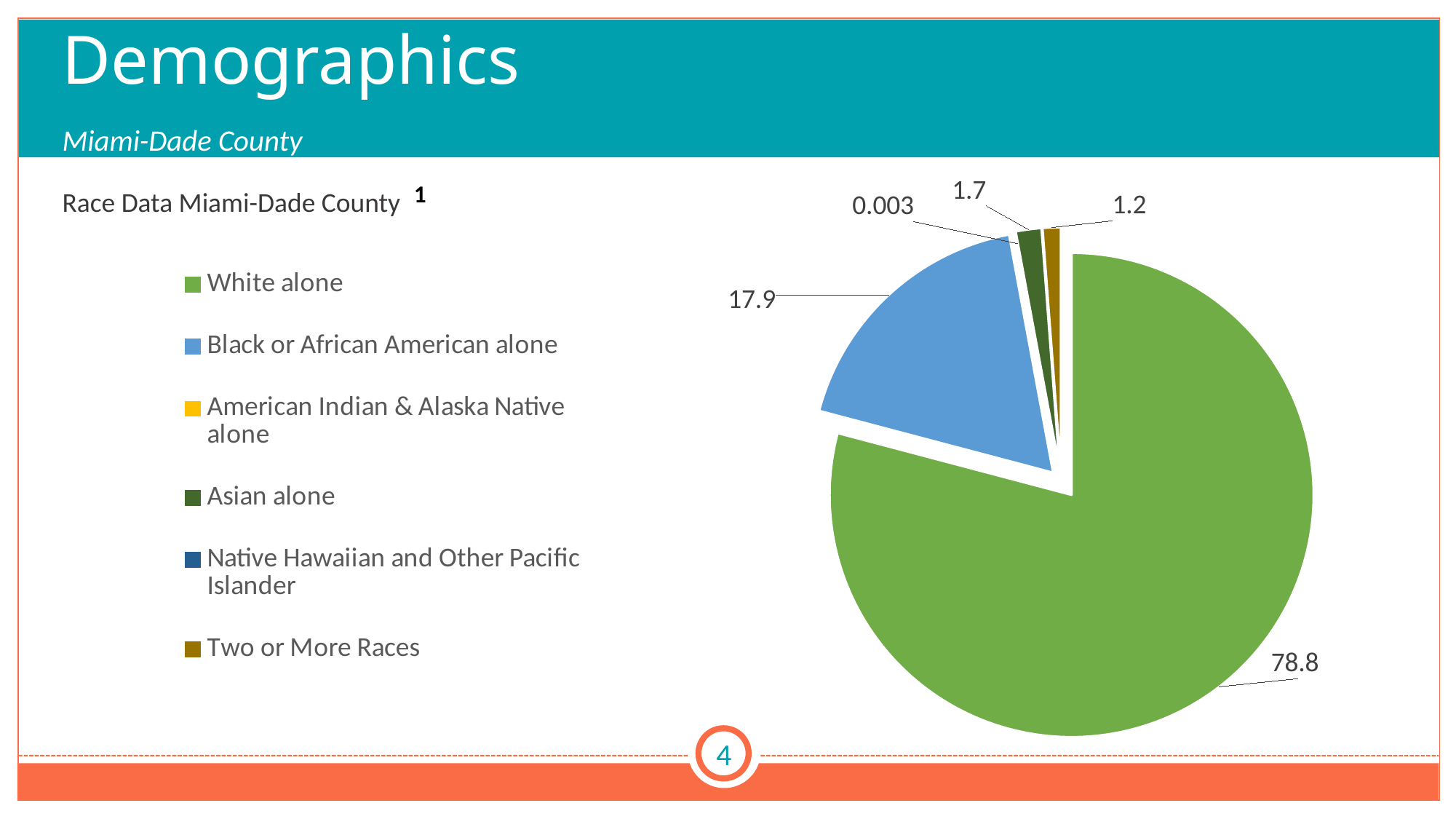
What kind of chart is shown on the slide? pie chart What is the value shown for Asian alone? 1.7 What is the difference between the values for White alone and Black or African American alone? 60.9 What colour represents Black or African American alone in the chart? blue What is the value shown for White alone? 78.8 What is the smallest value labeled on the pie chart? 0.003 How many categories does the legend list? 6 Which category has the largest slice of the pie? White alone What is the title of the chart? Race Data Miami-Dade County Which is larger, the value for Asian alone or the value for Two or More Races? Asian alone What is the value shown for Black or African American alone? 17.9 What is the value shown for Two or More Races? 1.2